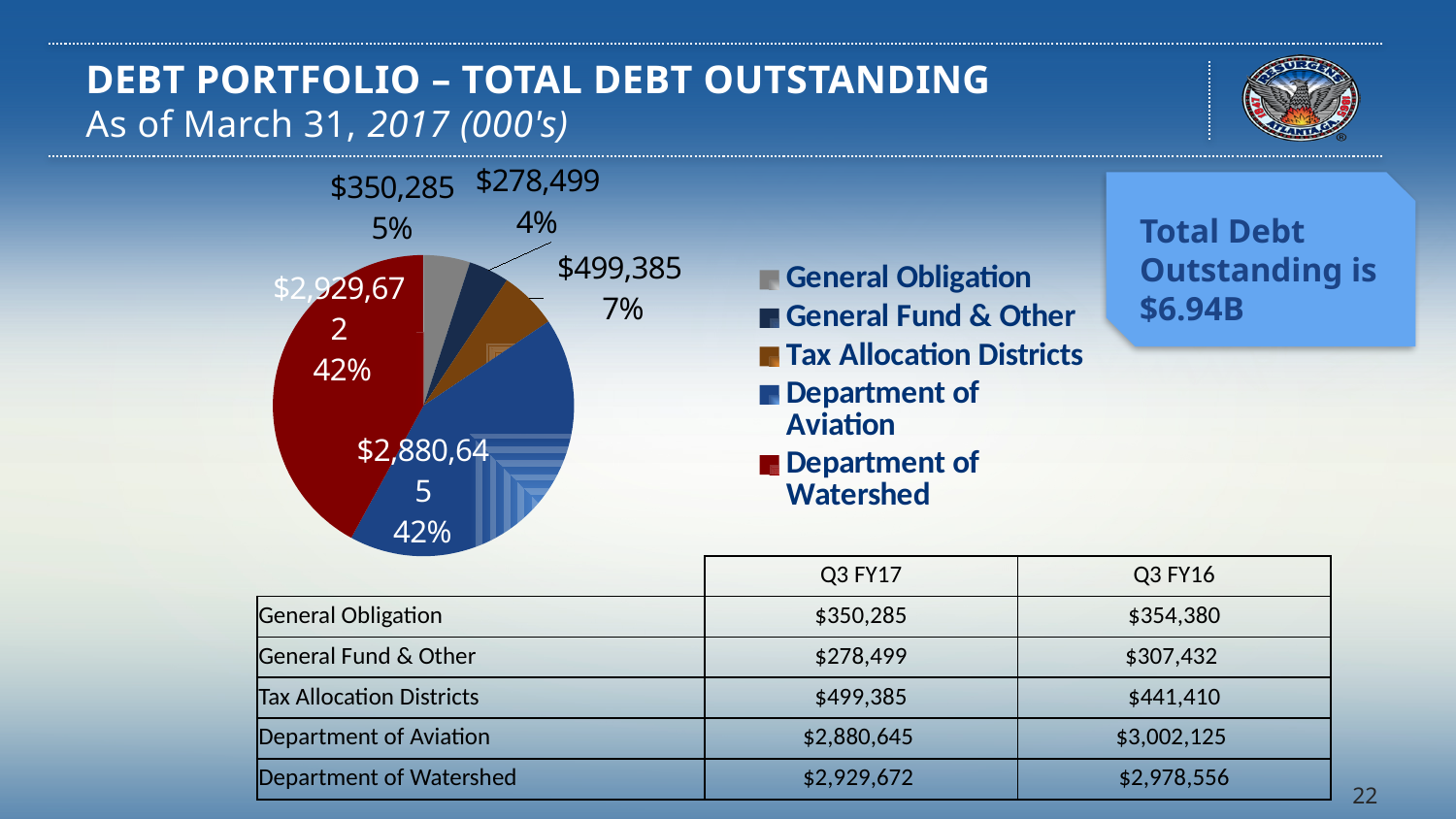
What is the value shown for Tax Allocation Districts in the pie chart? $499,385 What share of the pie does Tax Allocation Districts represent? 7% Which category has the smallest slice in the pie chart? General Fund & Other What share of the pie does Department of Aviation represent? 42% What is the difference between the Tax Allocation Districts value and the General Obligation value in the pie chart? $149,100 According to the callout box next to the pie chart, what is the total debt outstanding? $6.94B What kind of chart is shown on the slide? Pie chart Which is larger in the pie chart, Tax Allocation Districts or General Obligation? Tax Allocation Districts What is the value shown for General Fund & Other in the pie chart? $278,499 How many entries does the pie chart's legend list? 5 How many slices does the pie chart have? 5 What is the value shown for General Obligation in the pie chart? $350,285